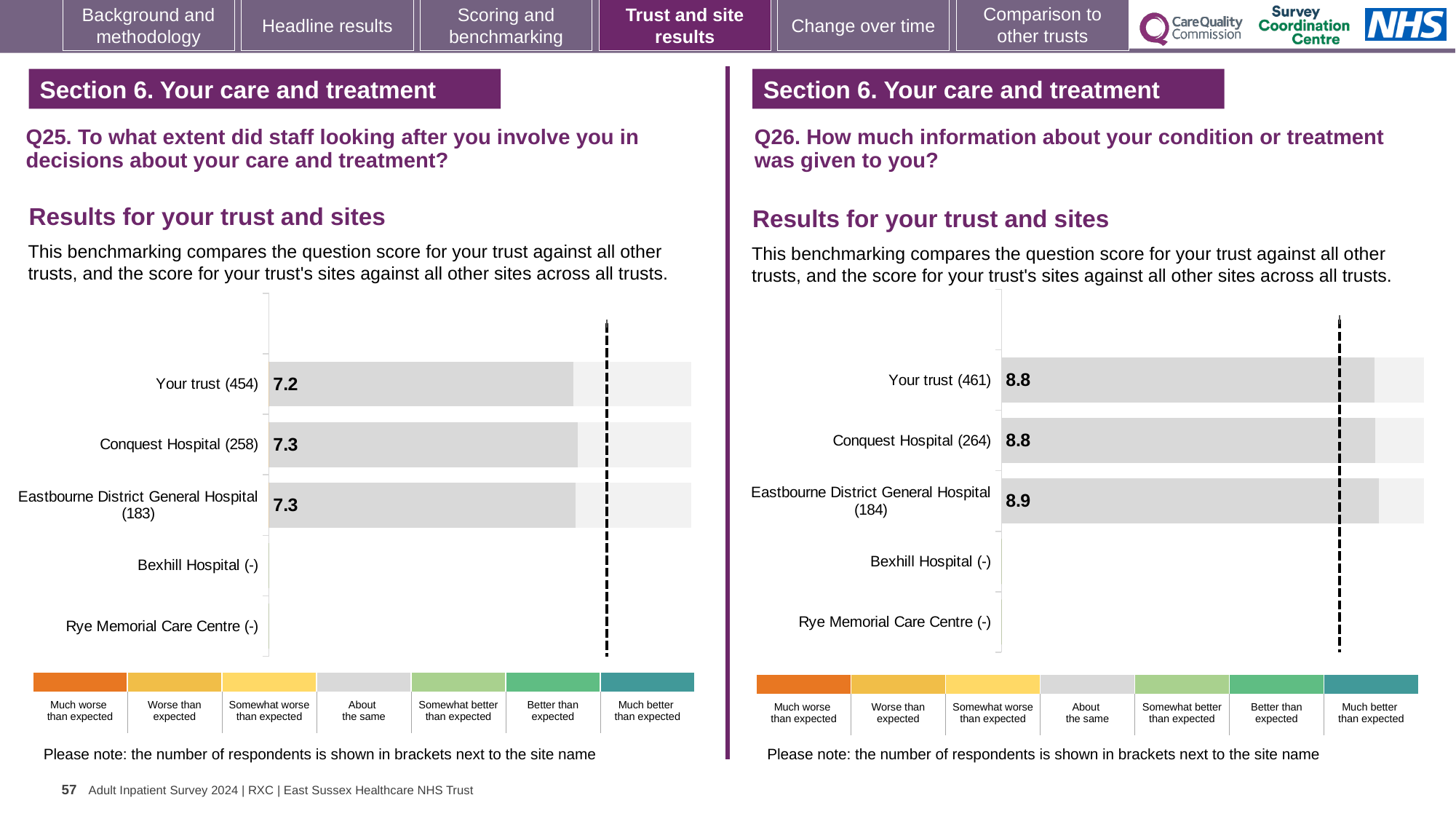
In the Q26 chart on the right, how many respondents are shown in brackets for Your trust? 461 In the Q26 chart on the right, which site or trust row has the highest score? Eastbourne District General Hospital In the Q25 chart on the left, which row has the lowest score among those with a value shown? Your trust In the Q25 chart on the left, what is the difference between the Conquest Hospital score and the Your trust score? 0.1 In the Q26 chart on the right, what is the score for Your trust? 8.8 In the Q26 chart on the right, which is larger: the score for Eastbourne District General Hospital or the score for Conquest Hospital? Eastbourne District General Hospital What kind of chart is used for the Q26 results on the right? Bar chart In the Q25 chart on the left, what is the score for Conquest Hospital? 7.3 In the Q25 chart on the left, how many respondents are shown in brackets for Eastbourne District General Hospital? 183 In the Q26 chart on the right, what is the score for Eastbourne District General Hospital? 8.9 How many rows (trust and sites) are listed on the y axis of the Q25 chart on the left? 5 In the Q25 chart on the left, what is the score for Your trust? 7.2